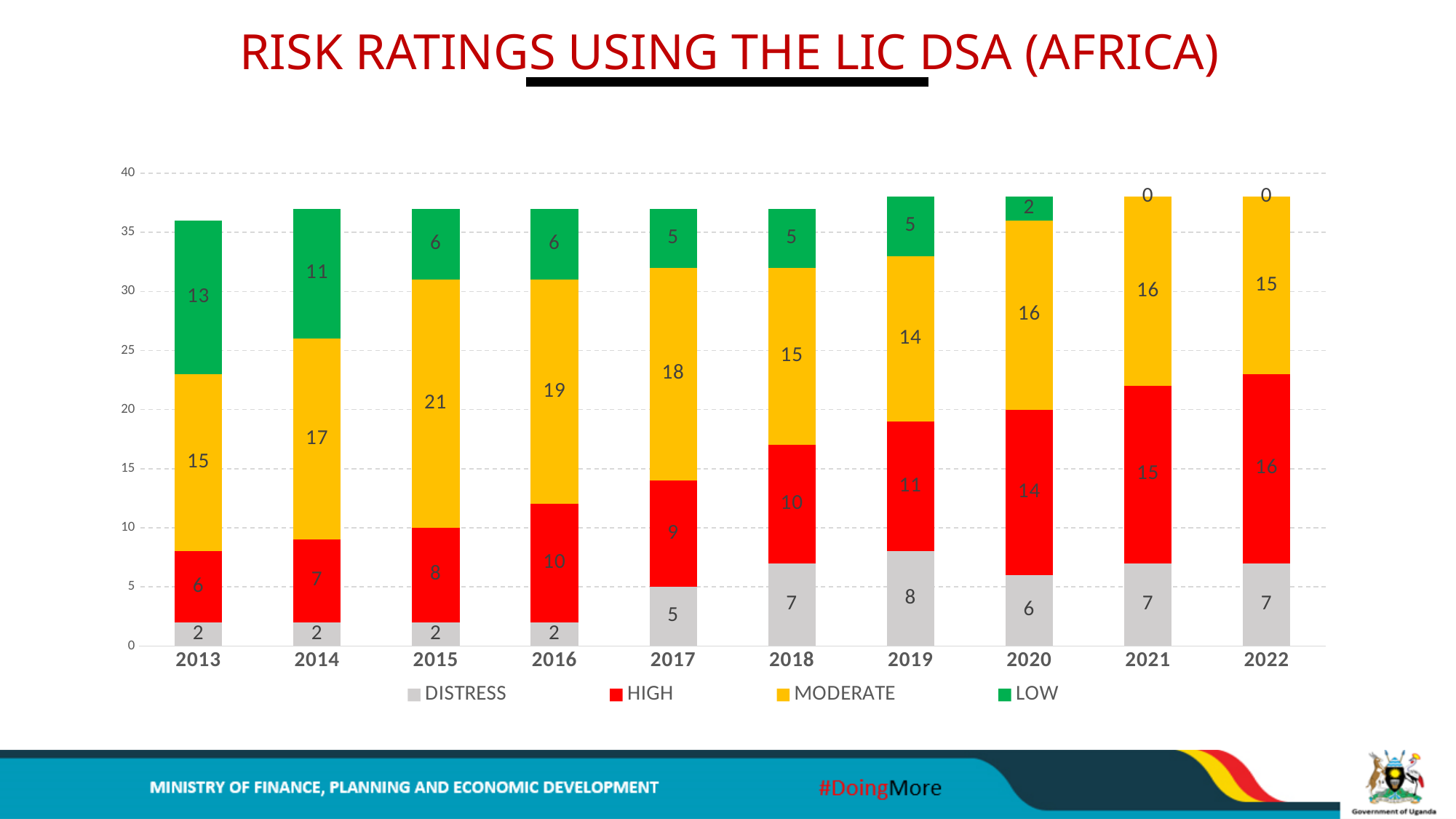
What is the value for HIGH in 2016? 10 In which year is the MODERATE value the largest? 2015 What is the value for MODERATE in 2015? 21 In which year is the HIGH value the largest? 2022 What is the value for LOW in 2013? 13 What is the value for DISTRESS in 2019? 8 What is the total of the stacked bar for 2013? 36 What is the difference between the LOW value in 2013 and the LOW value in 2014? 2 Which is larger, the HIGH value in 2020 or the HIGH value in 2018? 2020 What is the total of the stacked bar for 2022? 38 How many years are shown on the x axis? 10 How many series does the legend list? 4